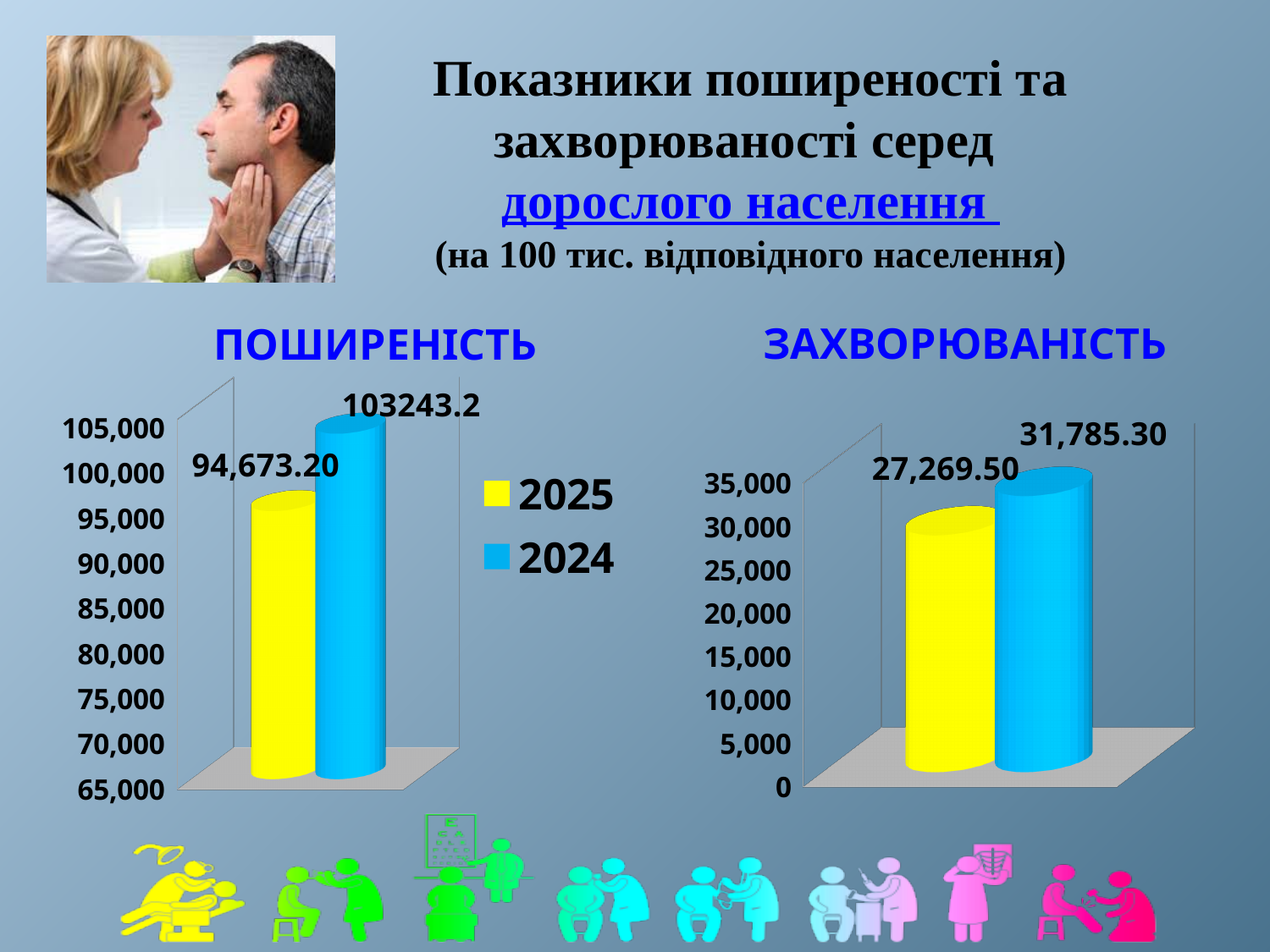
In the ПОШИРЕНІСТЬ chart, is the value for 2025 greater or less than 100,000? less In the ЗАХВОРЮВАНІСТЬ chart, what is the value for 2024? 31,785.30 In the ЗАХВОРЮВАНІСТЬ chart, is the value for 2024 greater or less than 30,000? greater In the ЗАХВОРЮВАНІСТЬ chart, what is the difference between the 2024 and 2025 values? 4,515.80 Which colour represents 2025 in the legend? yellow In the ПОШИРЕНІСТЬ chart, what is the value for 2024? 103243.2 In the ЗАХВОРЮВАНІСТЬ chart, which year has the lower value? 2025 In the ПОШИРЕНІСТЬ chart, which year has the higher value? 2024 In the ПОШИРЕНІСТЬ chart, what is the value for 2025? 94,673.20 In the ЗАХВОРЮВАНІСТЬ chart, what is the value for 2025? 27,269.50 What kind of chart is the ЗАХВОРЮВАНІСТЬ chart? bar chart How many series does the legend list? 2